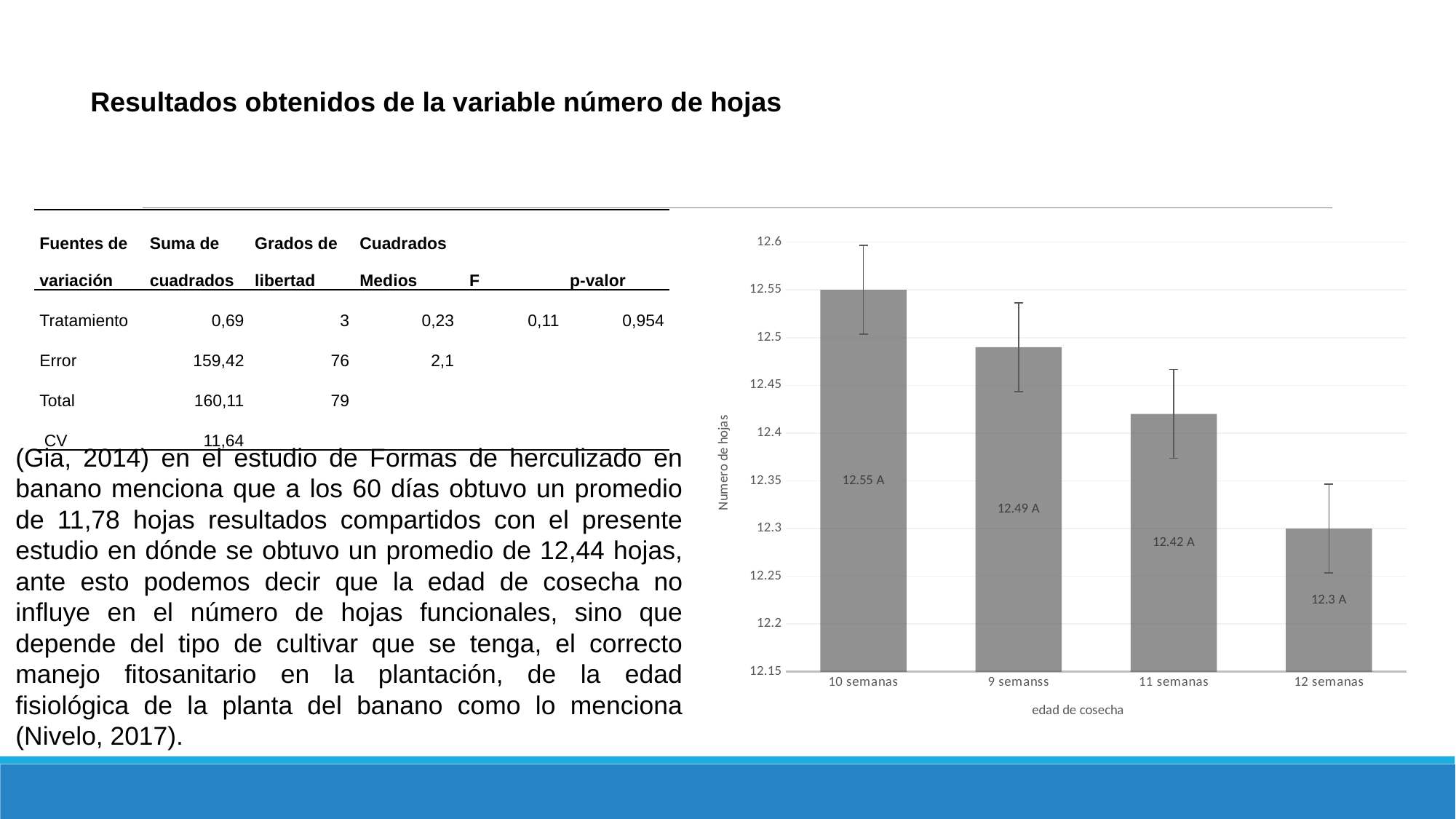
What kind of chart is shown? bar chart Do the values rise or fall from left to right along the x axis? fall What is the value for 10 semanas? 12.55 A How many categories are shown on the x axis? 4 What is the value for 11 semanas? 12.42 A Which category has the highest value? 10 semanas What is the difference between the values for 10 semanas and 12 semanas? 0.25 What is the label of the y axis? Numero de hojas Is the value for 12 semanas greater or less than 12.4? less Which is larger, the value for 9 semanss or the value for 11 semanas? 9 semanss Which category has the lowest value? 12 semanas What is the value for 12 semanas? 12.3 A